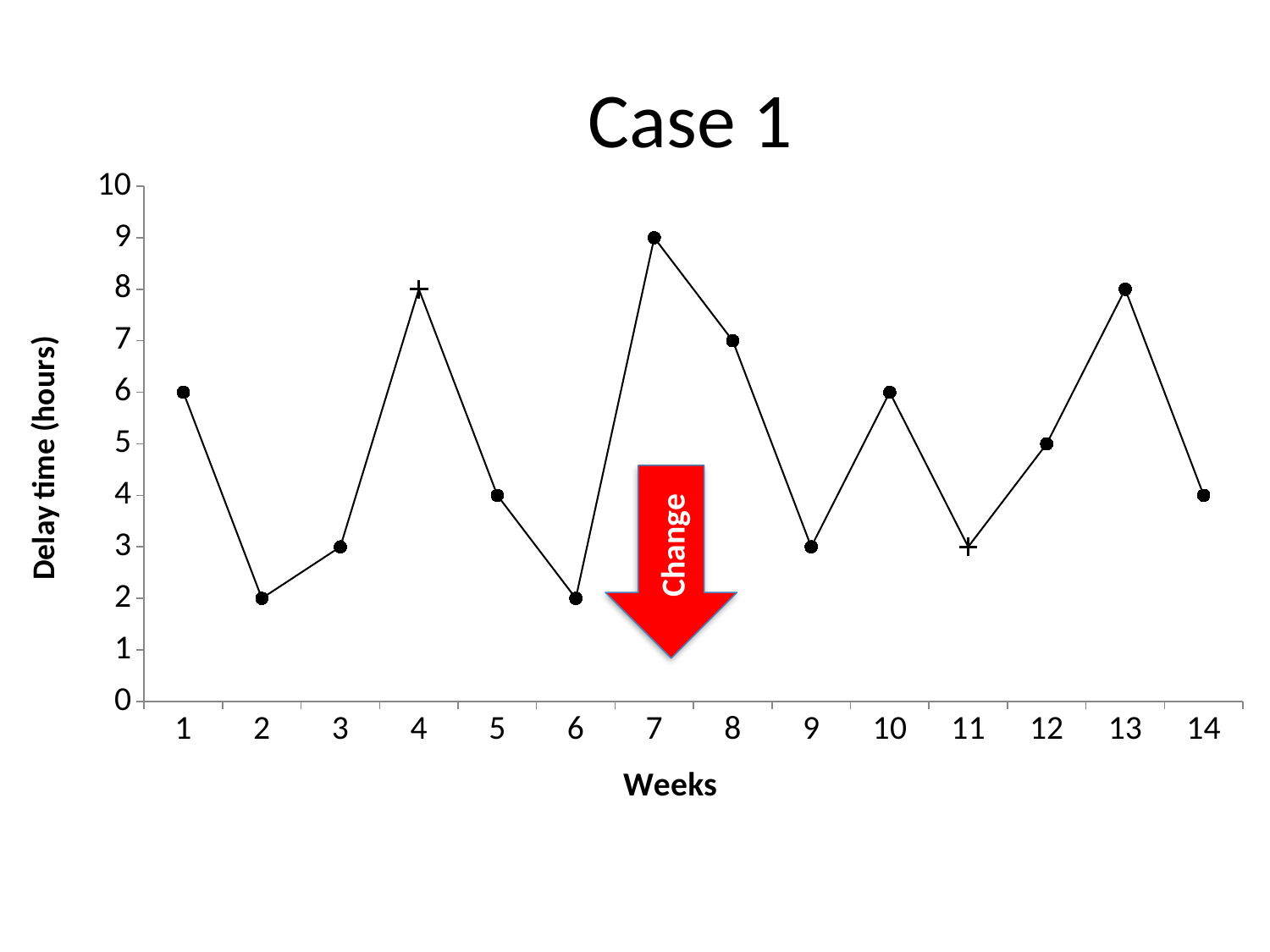
How many weeks are plotted on the chart? 14 What is the label on the y axis? Delay time (hours) What is the delay time in week 7? 9 Which has a larger delay time, week 4 or week 5? Week 4 What is the difference in delay time between week 7 and week 6? 7 Does the delay time rise or fall from week 8 to week 9? Fall What is the delay time in week 12? 5 Which week has the highest delay time? Week 7 What is the delay time in week 1? 6 What is the title of the chart? Case 1 Is the delay time in week 13 greater or less than 5? greater What kind of chart is shown on the slide? Line chart